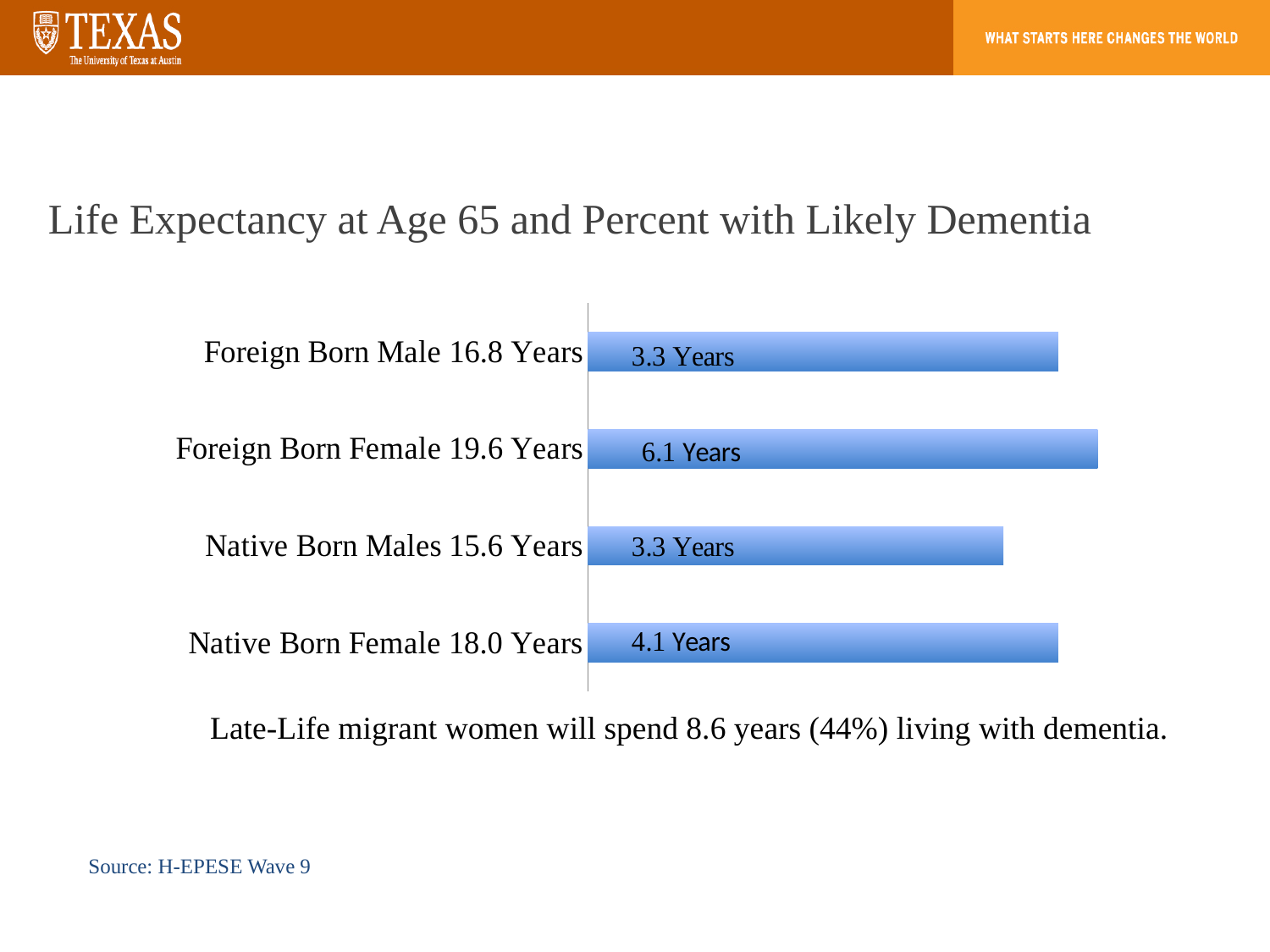
What kind of chart is shown on the slide? Bar chart What is the difference between the labelled values for Foreign Born Female 19.6 Years and Native Born Males 15.6 Years? 2.8 Years What is the title of the chart on the slide? Life Expectancy at Age 65 and Percent with Likely Dementia What colour are the bars in the chart? Blue Which category has the highest labelled value in the chart? Foreign Born Female 19.6 Years What is the data label on the bar for Foreign Born Female 19.6 Years? 6.1 Years What is the data label on the bar for Native Born Males 15.6 Years? 3.3 Years What is the data label on the bar for Foreign Born Male 16.8 Years? 3.3 Years Which has the larger labelled value: Foreign Born Female 19.6 Years or Native Born Female 18.0 Years? Foreign Born Female 19.6 Years What is the data label on the bar for Native Born Female 18.0 Years? 4.1 Years What is the difference between the labelled values for Foreign Born Female 19.6 Years and Native Born Female 18.0 Years? 2.0 Years How many categories are shown in the chart? 4